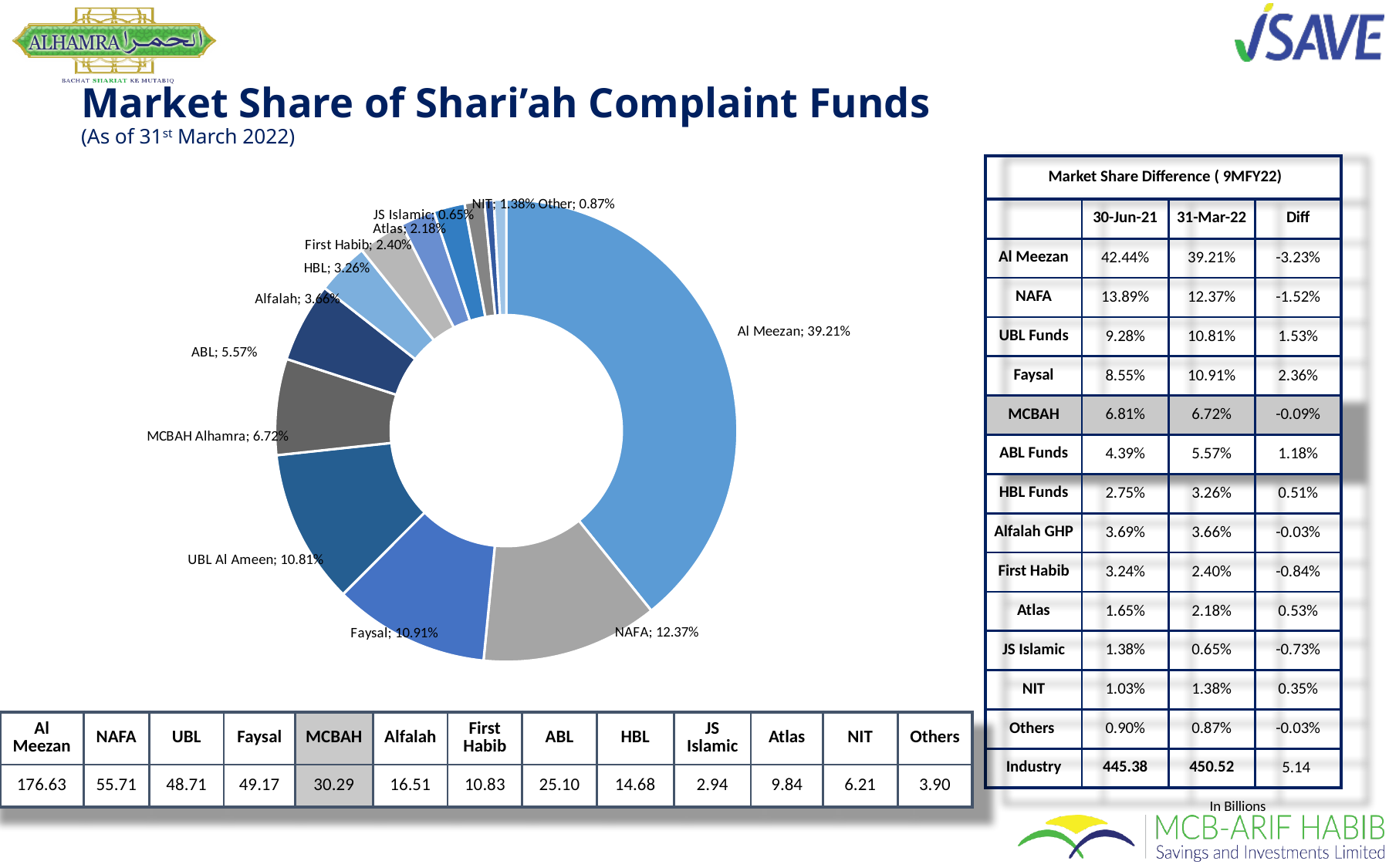
What is the value shown for First Habib in the doughnut chart? 2.40% What is the value shown for NAFA in the doughnut chart? 12.37% Which has the larger share in the doughnut chart, Faysal or UBL Al Ameen? Faysal What is the difference between the Al Meezan and NAFA shares in the doughnut chart? 26.84% What is the value shown for MCBAH Alhamra in the doughnut chart? 6.72% Which has the larger share in the doughnut chart, ABL or HBL? ABL What is the value shown for UBL Al Ameen in the doughnut chart? 10.81% Which category has the smallest slice in the doughnut chart? JS Islamic Which category has the largest slice in the doughnut chart? Al Meezan What type of chart is shown on the slide? Doughnut (pie) chart How many categories are shown in the doughnut chart? 13 What share of the doughnut chart does Al Meezan hold? 39.21%